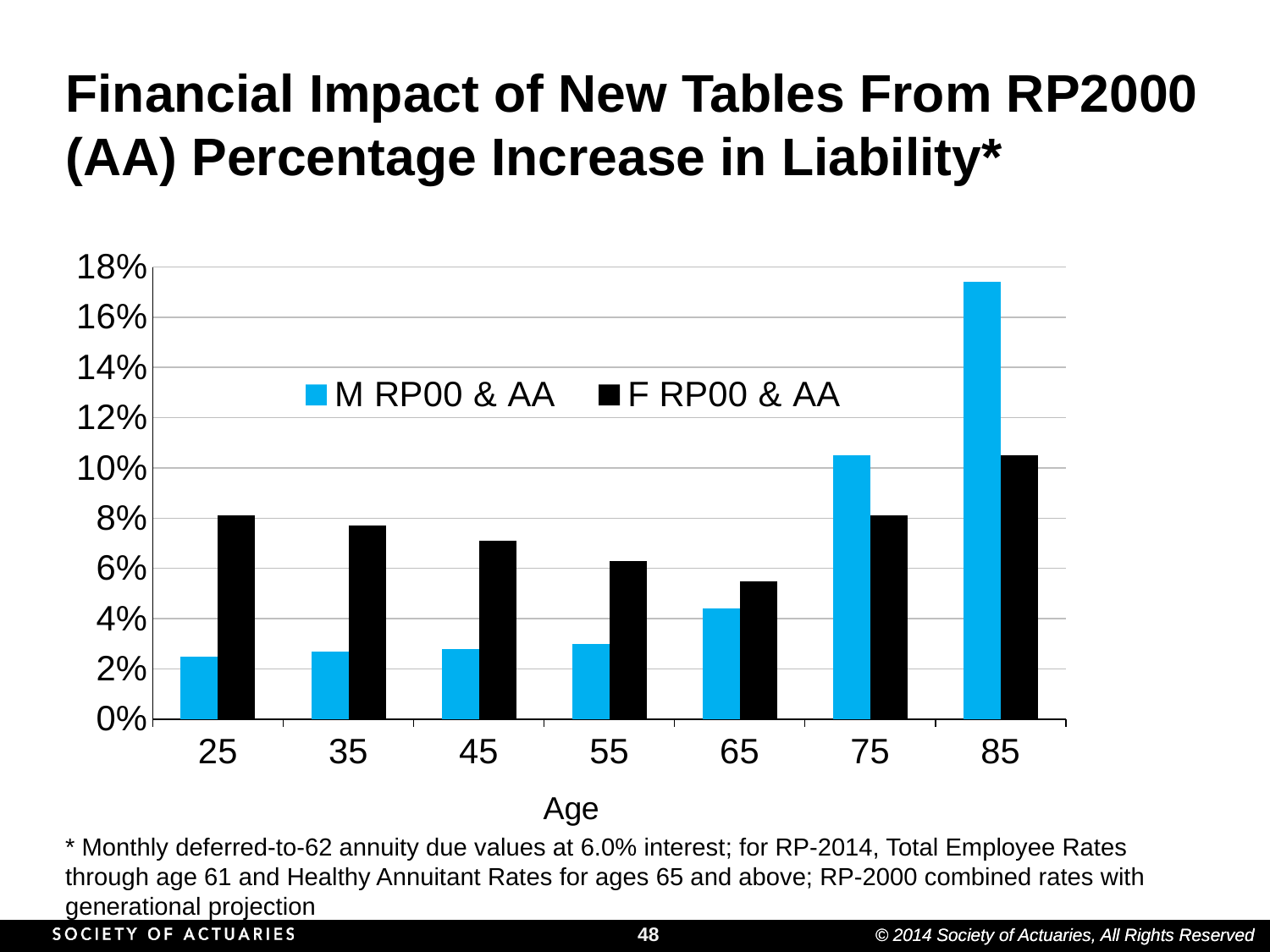
What kind of chart is shown on the slide? bar chart How many age categories are shown on the x axis? 7 At which age is the F RP00 & AA value lowest? 65 Do the M RP00 & AA values rise or fall as age increases from 25 to 85? rise Is the M RP00 & AA value at age 25 greater or less than 4%? less How many series does the legend list? 2 At which age is the M RP00 & AA value highest? 85 At age 85, which series has the larger value, M RP00 & AA or F RP00 & AA? M RP00 & AA Is the M RP00 & AA value at age 85 greater or less than 16%? greater Is the F RP00 & AA value at age 25 greater or less than 6%? greater At age 25, which series has the larger value, M RP00 & AA or F RP00 & AA? F RP00 & AA At which age is the F RP00 & AA value highest? 85